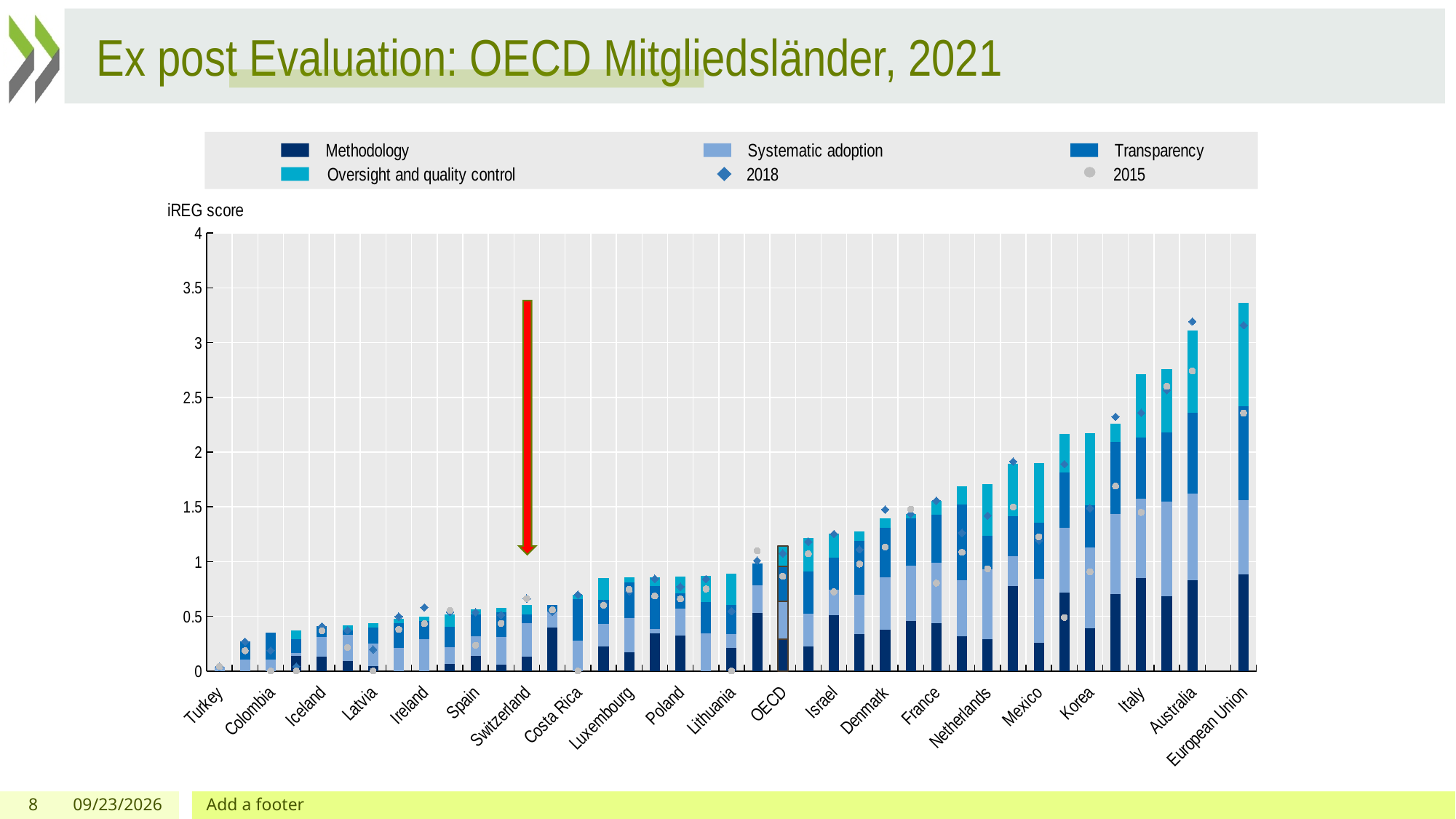
Which category has the lowest stacked bar? Turkey What kind of chart is shown on the slide? bar chart Is the total bar value for Mexico greater or less than 2? less Is the total bar value for European Union greater or less than 3? greater Do the stacked bar totals generally rise or fall from left to right along the x axis? rise How many entries does the chart legend list? 6 What is the label on the vertical axis of the chart? iREG score Is the total bar value for Italy greater or less than 2.5? greater Which has the larger stacked bar, Australia or Italy? Australia Which category has the highest stacked bar? European Union